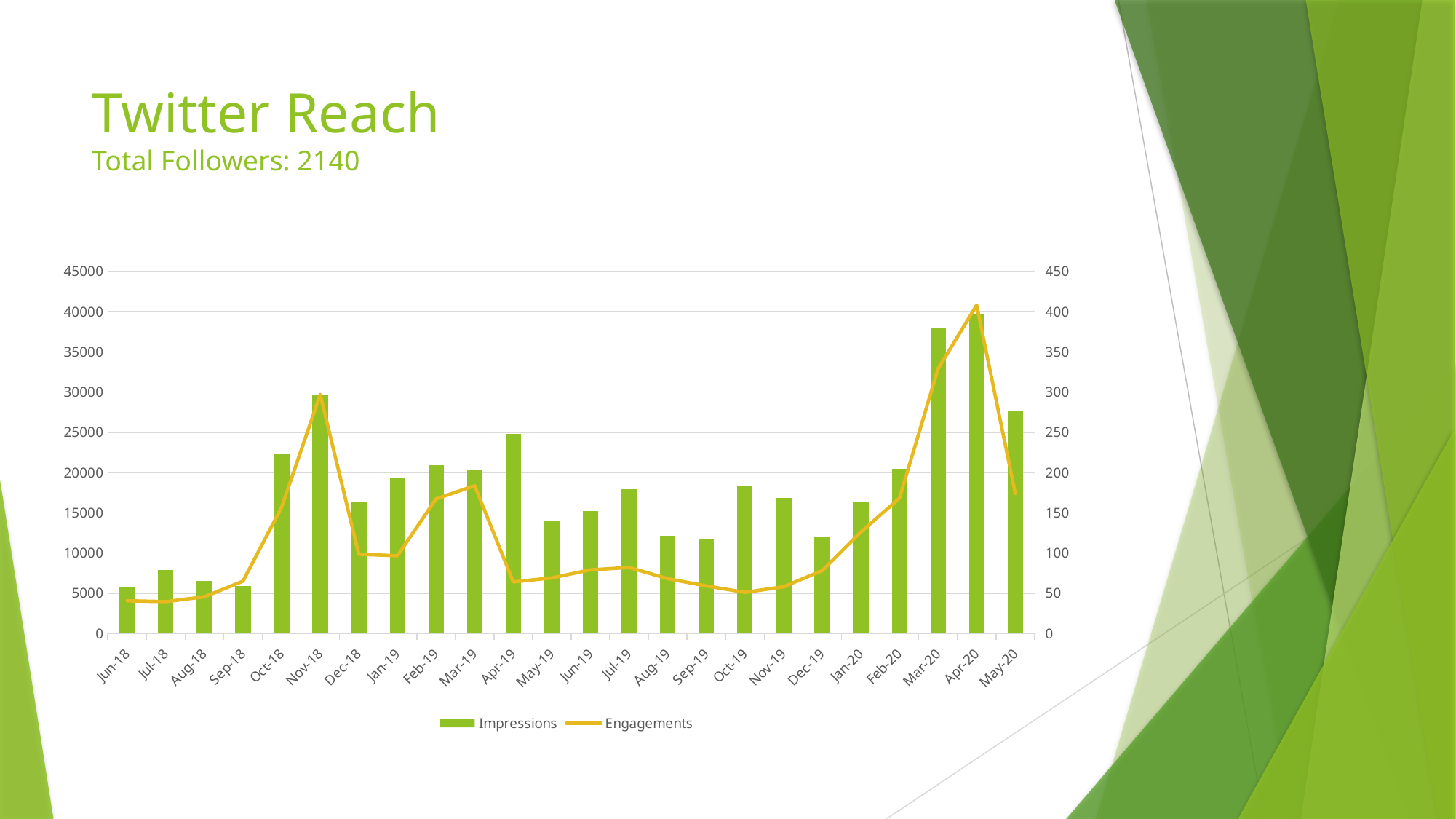
Is the Engagements value for Oct-19 greater or less than 100? less Which month has the larger Impressions value, Mar-20 or May-20? Mar-20 Which month has the larger Impressions value, Oct-18 or Nov-18? Nov-18 What are the two series named in the chart legend? Impressions and Engagements What kind of chart is shown on the slide? Combined bar and line chart Which month has the highest Impressions bar? Apr-20 Do Impressions rise or fall from Feb-20 to Apr-20? rise Is the Impressions value for Nov-18 greater or less than 25000? greater Is the Impressions value for Mar-20 greater or less than 35000? greater How many series does the chart legend list? 2 How many months are plotted along the x axis of the chart? 24 In which month does the Engagements line reach its peak? Apr-20